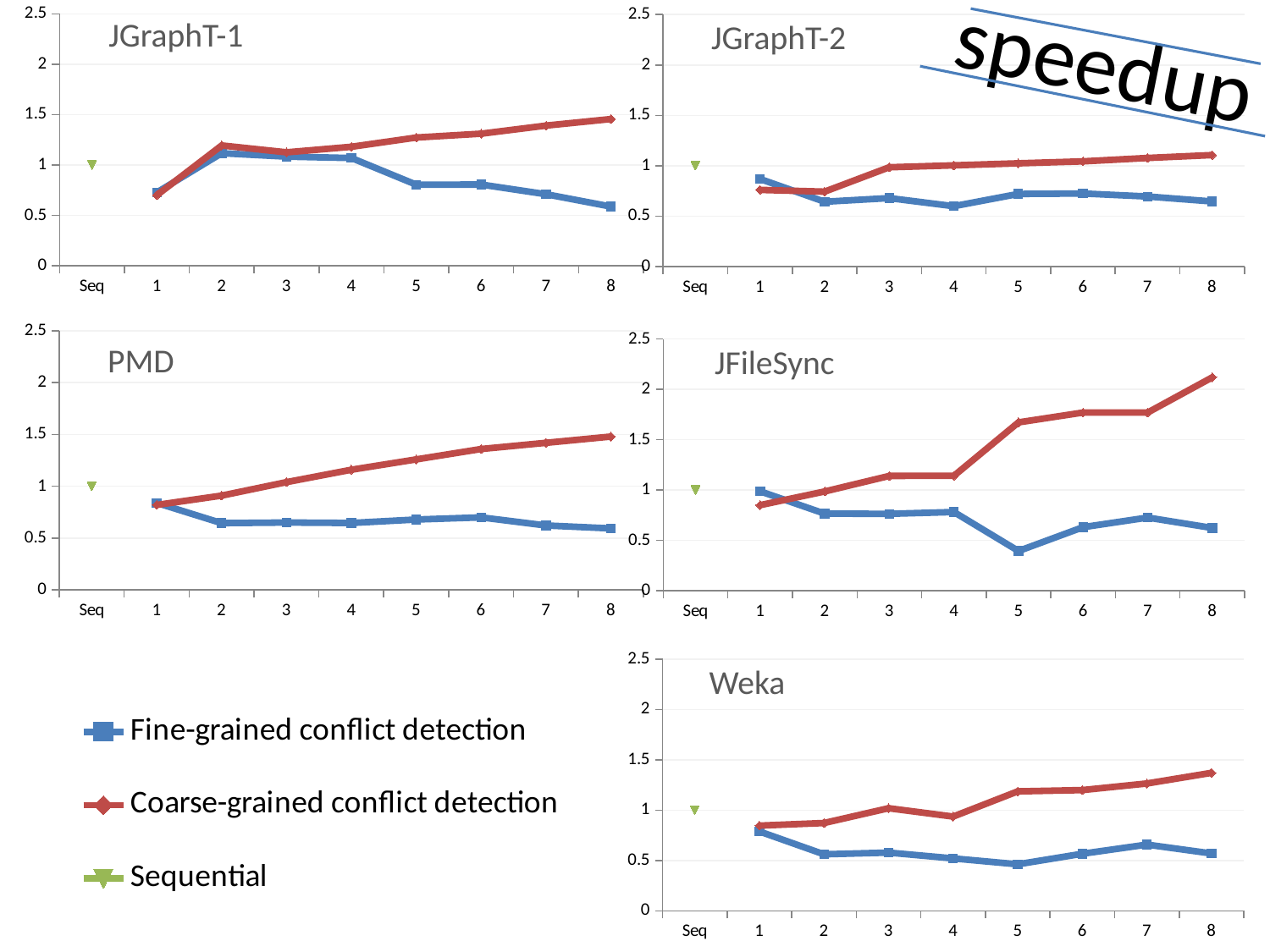
How many charts are shown on the slide? 5 What kind of chart is the JGraphT-1 chart? line chart In the JFileSync chart, is the Coarse-grained conflict detection value at 8 greater or less than 2? greater In the PMD chart, is the Fine-grained conflict detection value at 8 greater or less than 1? less In the JFileSync chart, at which x-axis value is the Coarse-grained conflict detection line highest? 8 In the PMD chart, how many points does the Coarse-grained conflict detection line have? 8 In the PMD chart, what is the value of the Sequential point? 1 In the JGraphT-1 chart, is the Coarse-grained conflict detection value at 8 greater or less than 1? greater In the Weka chart, which series has the larger value at 8, Fine-grained or Coarse-grained conflict detection? Coarse-grained conflict detection How many series does the legend list? 3 In the PMD chart, does the Coarse-grained conflict detection line rise or fall from 1 to 8? rise In the JFileSync chart, at which x-axis value is the Fine-grained conflict detection line lowest? 5